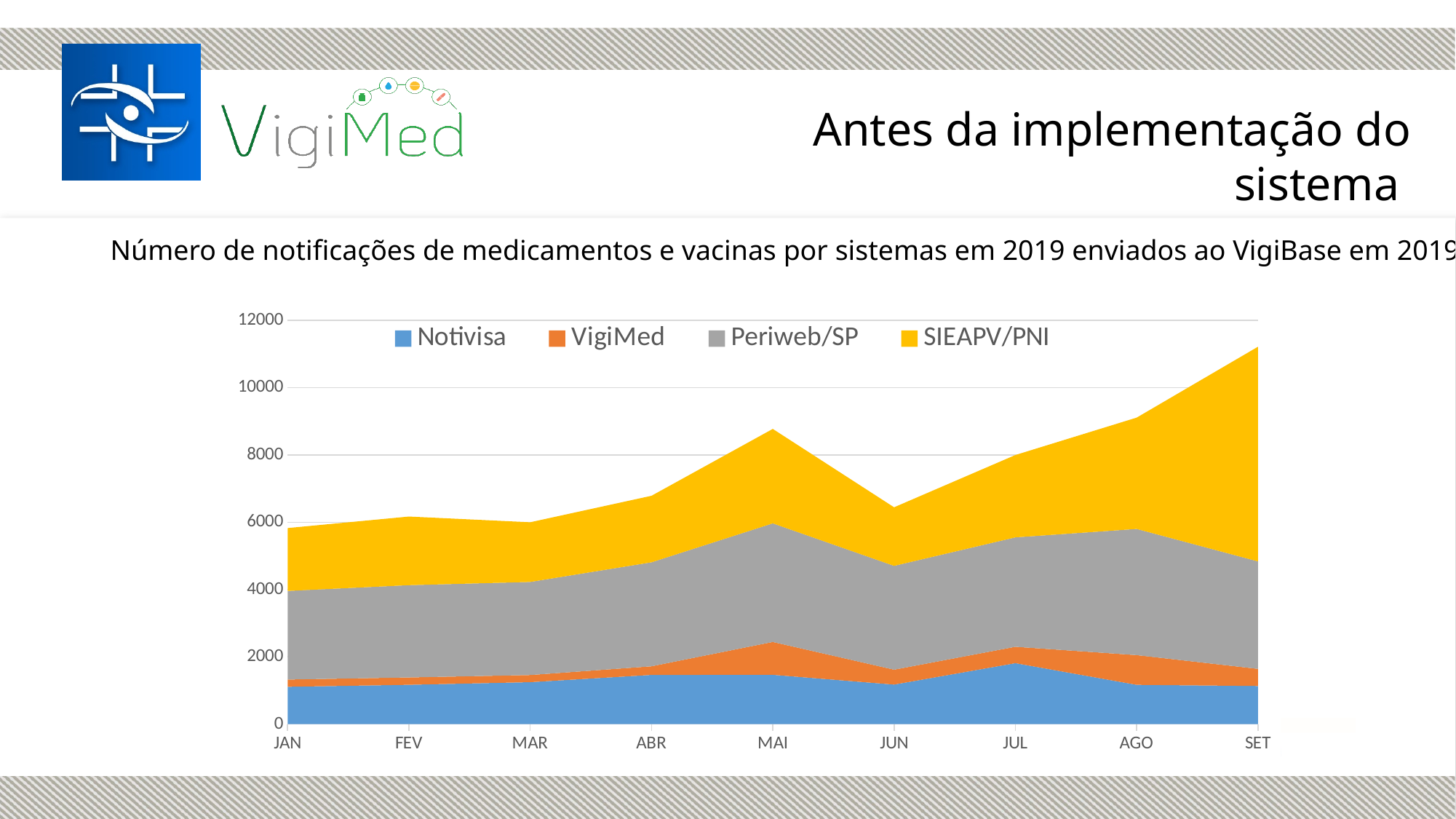
What kind of chart is shown on the slide? Area chart Is the stacked total for SET greater or less than 10000? greater In which month is the stacked total of all systems highest? SET Does the stacked total generally rise or fall from JAN to SET? rise Is the value for Notivisa in JAN greater or less than 2000? less How many series does the chart's legend list? 4 How many months are shown along the x axis of the chart? 9 Is the stacked total for JAN greater or less than 8000? less Which series is plotted at the bottom of the stacked areas? Notivisa Which series is shown in yellow in the chart? SIEAPV/PNI Which month has the larger stacked total, JAN or SET? SET